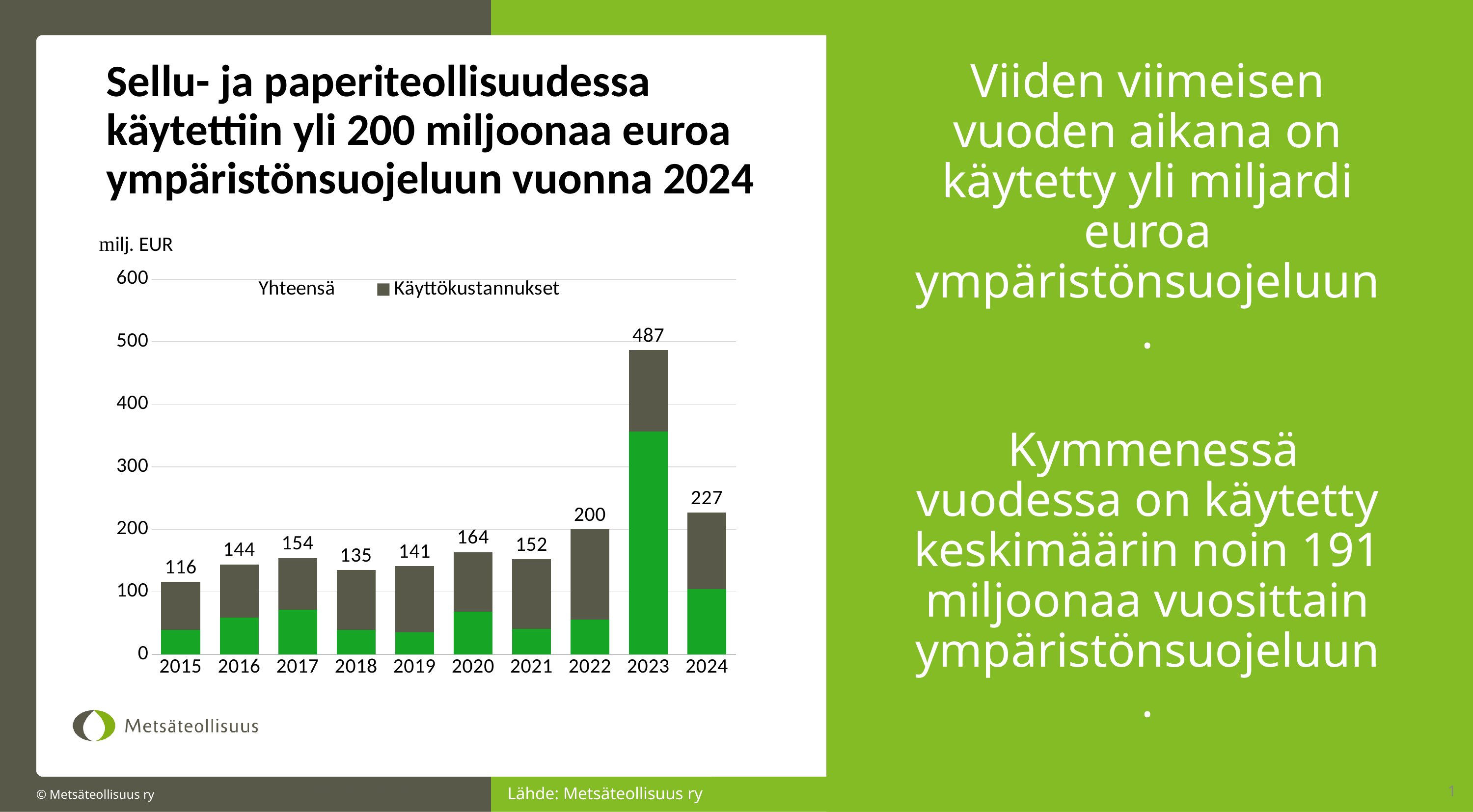
Which year has a larger total, 2018 or 2020? 2020 What is the total value shown for 2015? 116 What is the difference between the total for 2023 and the total for 2024? 260 Which year has the lowest total value? 2015 Which year has the highest total value? 2023 Is the green segment of the 2017 bar greater or less than 100? less How many entries does the legend list? 2 What kind of chart is shown on the slide? Stacked bar chart Is the green segment of the 2023 bar greater or less than 300? greater What is the total value shown for 2024? 227 How many years are shown on the x axis? 10 What is the total value shown for 2022? 200